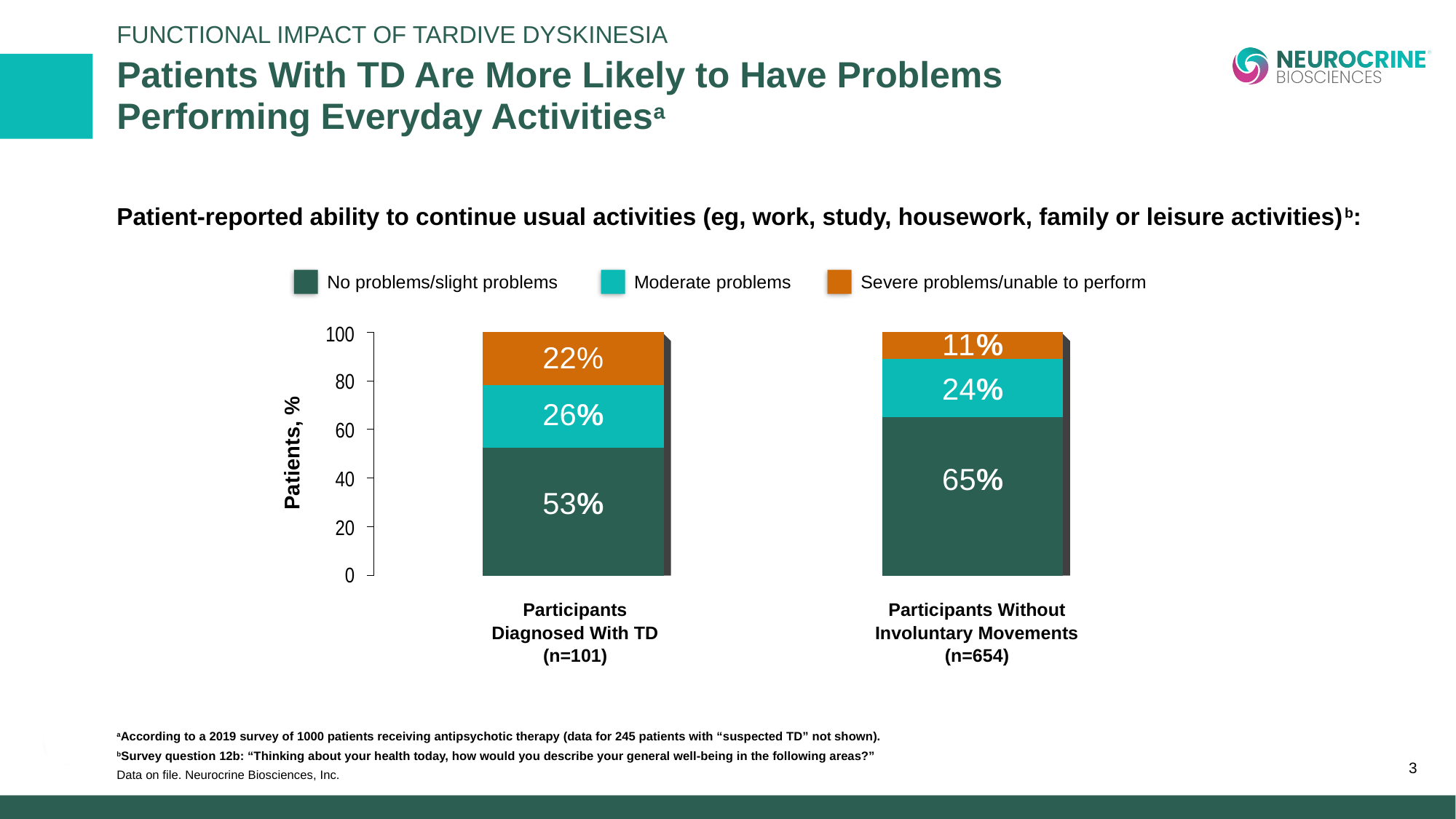
What percentage of participants diagnosed with TD reported no problems/slight problems? 53% What is the label of the y axis? Patients, % Which group has the larger share reporting no problems/slight problems? Participants Without Involuntary Movements Which group has the larger share reporting severe problems/unable to perform? Participants Diagnosed With TD How many participant groups are shown on the x axis? 2 What is the difference in the severe problems/unable to perform percentage between participants diagnosed with TD and participants without involuntary movements? 11 percentage points What percentage of participants without involuntary movements reported moderate problems? 24% What kind of chart is shown on the slide? Stacked bar chart Which colour represents severe problems/unable to perform in the legend? Orange What percentage of participants diagnosed with TD reported moderate problems? 26% What percentage of participants without involuntary movements reported severe problems/unable to perform? 11% How many series does the legend list? 3